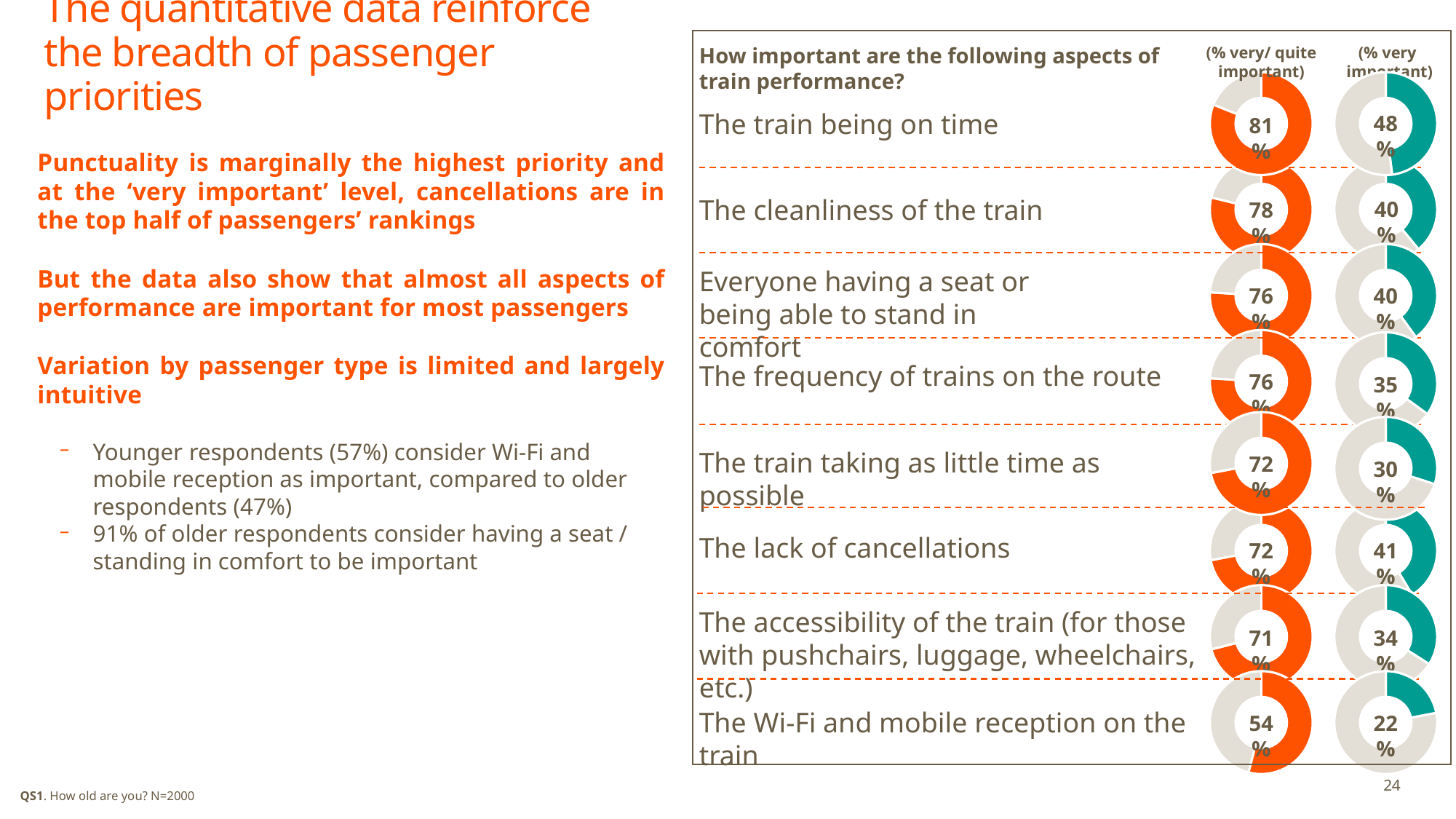
In the '% very important' column, what is the value for 'The lack of cancellations'? 41% What is the difference in '% very important' between 'The train being on time' and 'The Wi-Fi and mobile reception on the train'? 26% In the '% very important' column, which is larger: 'The lack of cancellations' or 'The train taking as little time as possible'? The lack of cancellations What colour are the donut charts in the '% very important' column? Teal In the '% very/ quite important' column, what is the value for 'The train being on time'? 81% How many aspects of train performance are shown in the chart? 8 Which aspect has the highest '% very/ quite important' value? The train being on time In the '% very important' column, what is the value for 'The frequency of trains on the route'? 35% Which aspect has the lowest '% very important' value? The Wi-Fi and mobile reception on the train What kind of chart is used to show each value? Donut chart In the '% very/ quite important' column, what is the value for 'The Wi-Fi and mobile reception on the train'? 54% What is the difference between the '% very/ quite important' and '% very important' values for 'The cleanliness of the train'? 38%